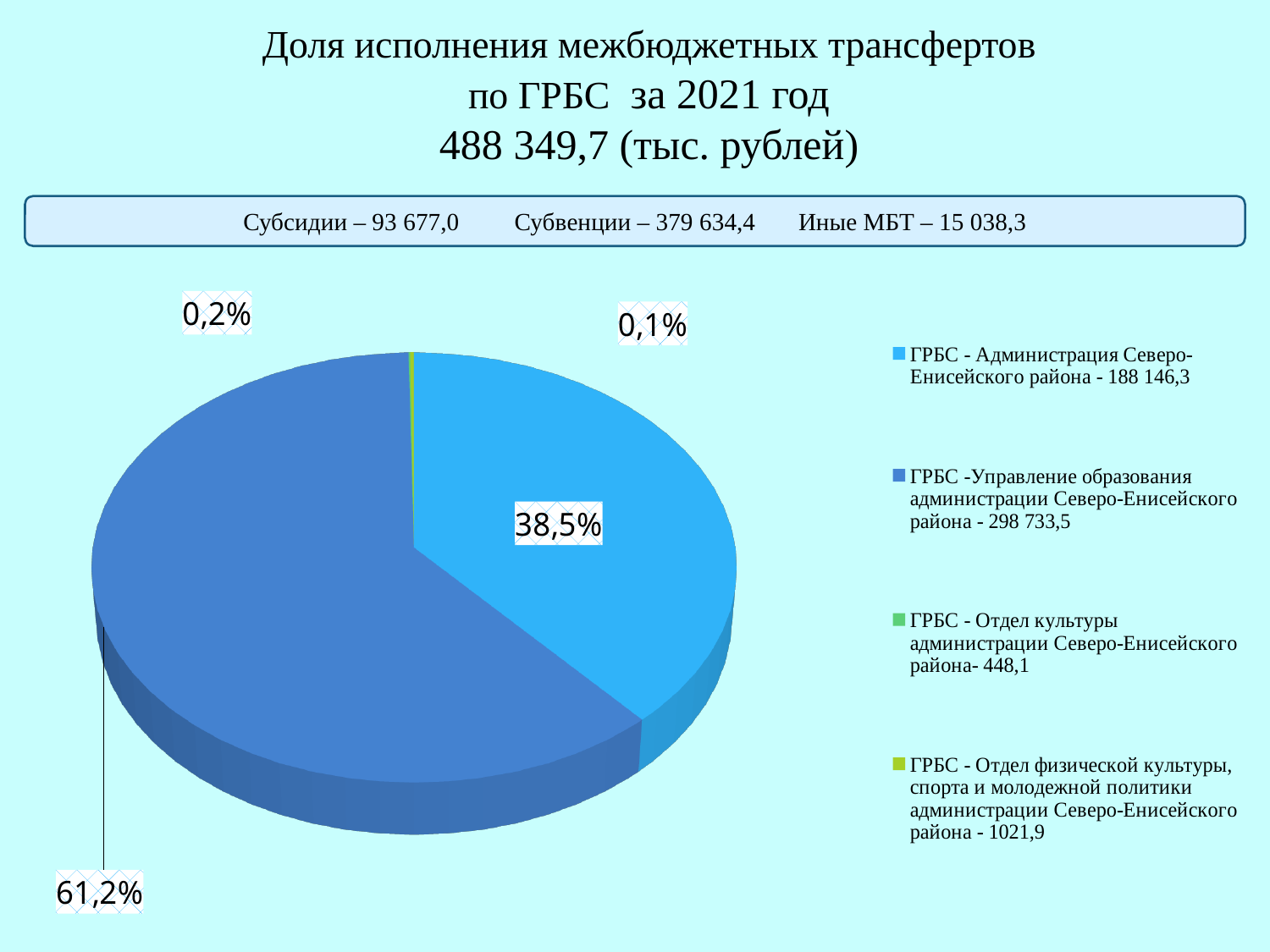
What share of the pie does ГРБС - Управление образования администрации Северо-Енисейского района have? 61,2% What value is given in the legend for ГРБС - Отдел физической культуры, спорта и молодежной политики администрации Северо-Енисейского района? 1021,9 Which category has the largest slice of the pie? ГРБС - Управление образования администрации Северо-Енисейского района What kind of chart is shown on the slide? pie chart How many slices does the pie chart have? 4 What share of the pie does ГРБС - Администрация Северо-Енисейского района have? 38,5% What is the smallest percentage label shown on the pie chart? 0,1% Which is larger: the share for ГРБС - Администрация Северо-Енисейского района or the share for ГРБС - Управление образования администрации Северо-Енисейского района? ГРБС - Управление образования администрации Северо-Енисейского района What value is given in the legend for ГРБС - Управление образования администрации Северо-Енисейского района? 298 733,5 What total amount in thousand rubles is stated in the chart title for 2021? 488 349,7 What value is given in the legend for ГРБС - Отдел культуры администрации Северо-Енисейского района? 448,1 By how many percentage points does the share of ГРБС - Управление образования exceed the share of ГРБС - Администрация Северо-Енисейского района? 22,7